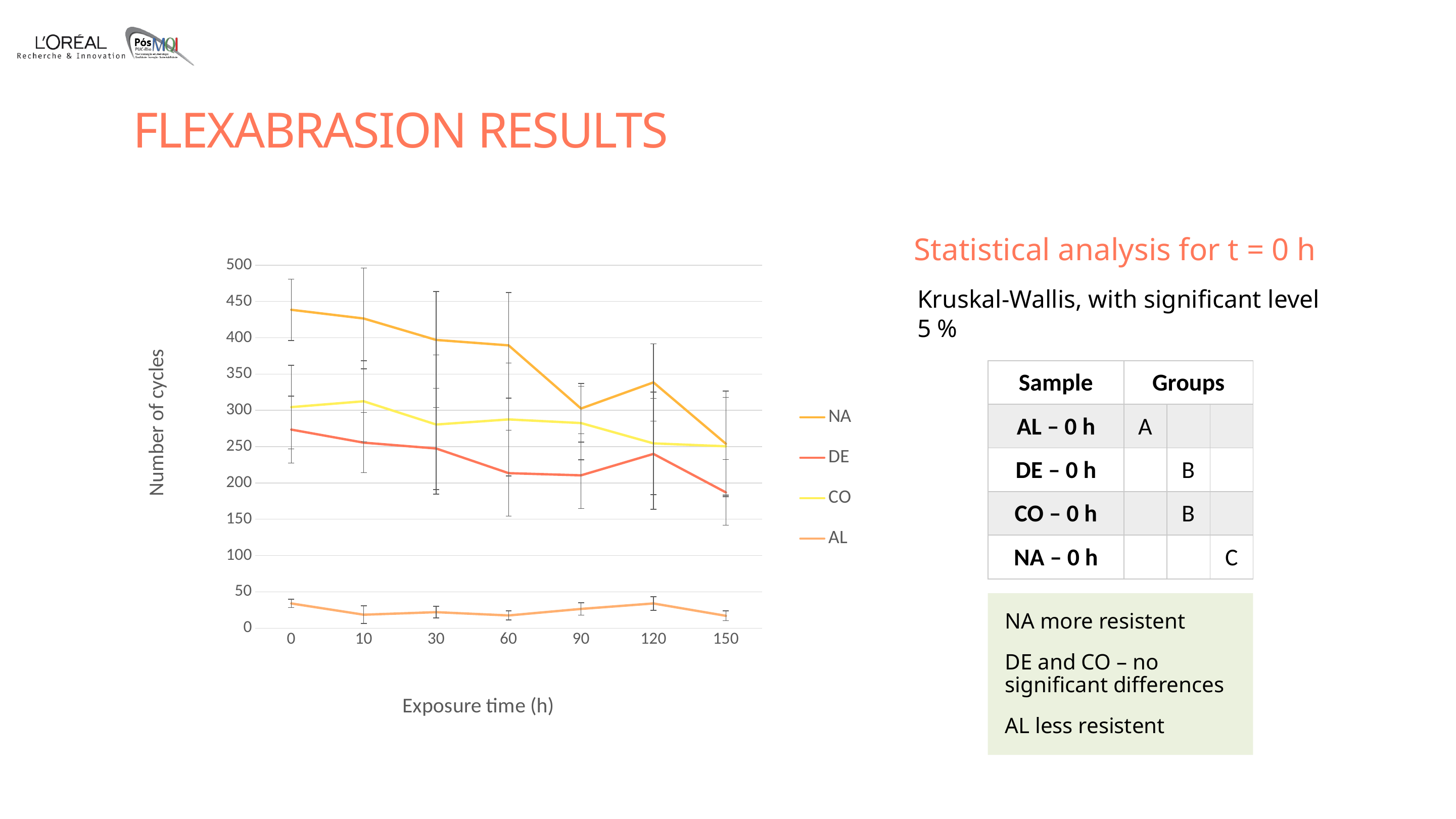
What kind of chart is shown on the slide? line chart Is the value for NA at 0 h greater or less than 400? greater Is the value for CO at 120 h greater or less than 300? less Is the value for AL at 0 h greater or less than 50? less How many series does the chart legend list? 4 What is the title of the chart's y axis? Number of cycles Does the NA series generally rise or fall as exposure time increases from 0 h to 150 h? fall Which series has the highest number of cycles at 0 h exposure time? NA At 90 h exposure time, which series has the larger value, NA or CO? NA How many exposure time points are plotted along the x axis? 7 Which series has the lowest number of cycles across all exposure times? AL